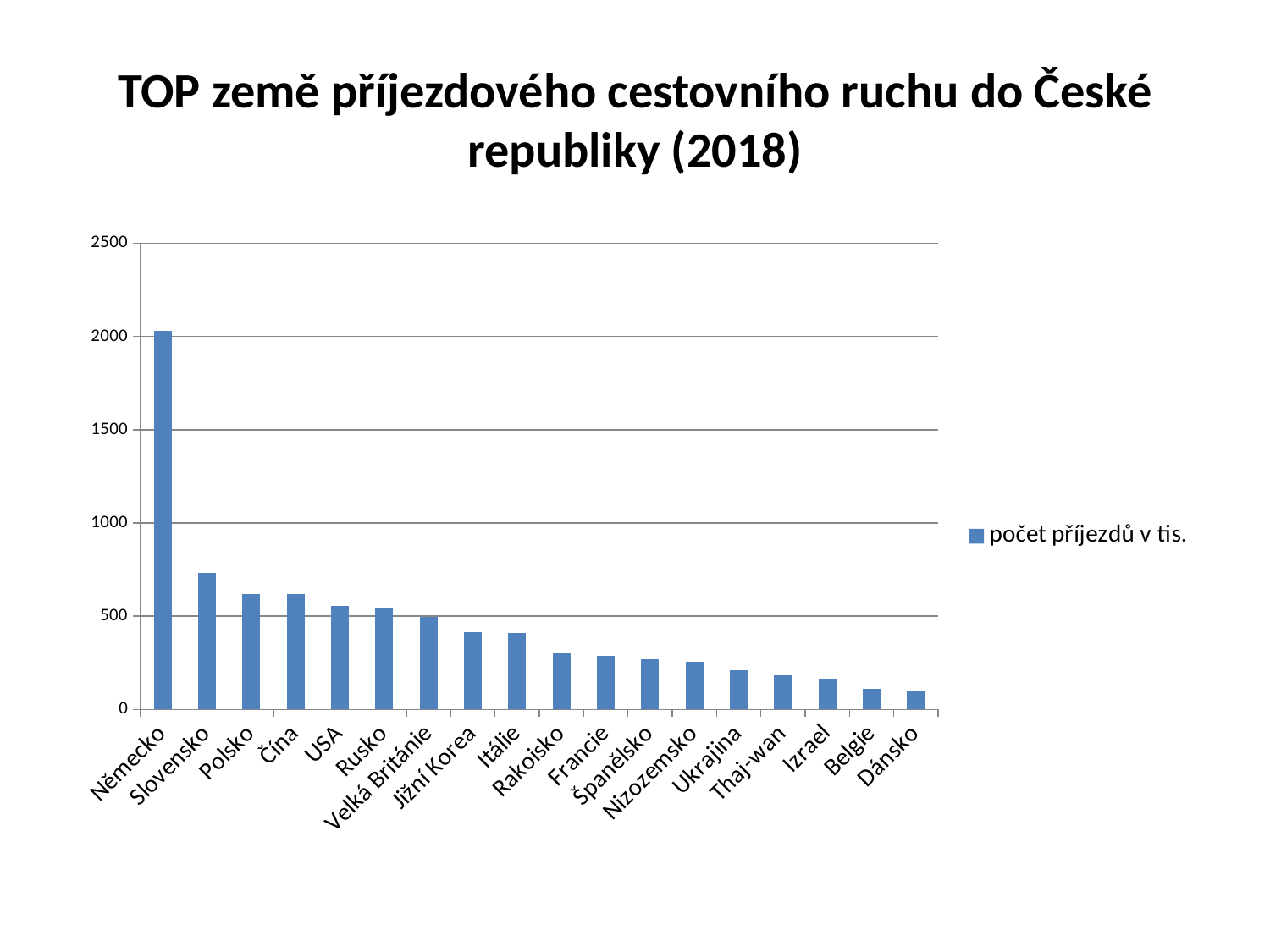
Which country has the highest number of arrivals in the chart? Německo Is the value for Německo greater or less than 1500? greater Which has a larger value, Německo or Slovensko? Německo What kind of chart is shown on the slide? bar chart Do the values rise or fall from left to right along the x axis? fall How many series does the legend list? 1 Is the value for Slovensko greater or less than 1000? less Is the value for Slovensko greater or less than 500? greater How many countries are shown on the x axis of the chart? 18